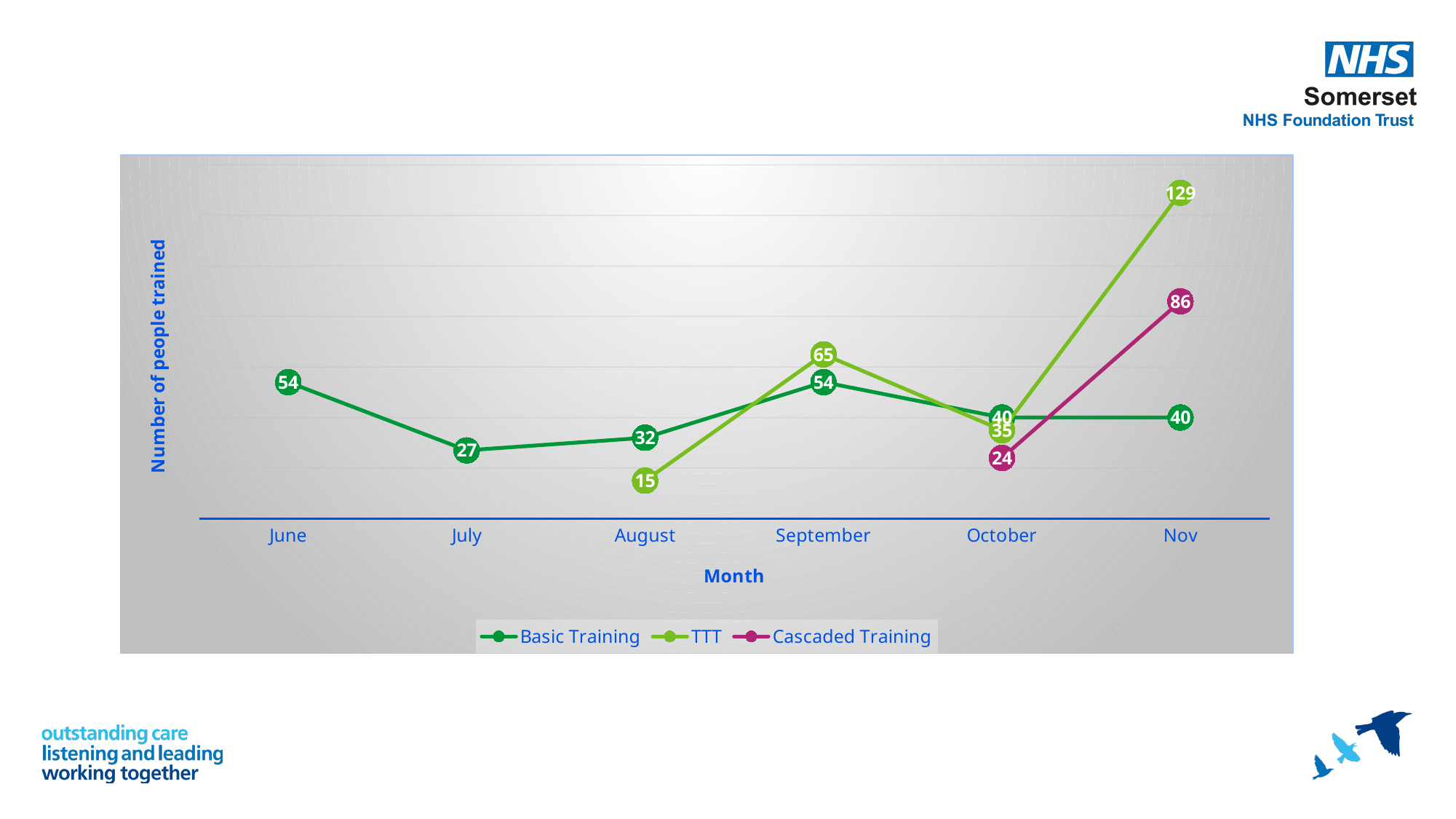
How many series does the legend list? 3 What is the value for Basic Training in June? 54 What is the value for TTT in Nov? 129 What is the difference between TTT and Basic Training in Nov? 89 What is the value for TTT in August? 15 What is the label of the y axis? Number of people trained In which month is Basic Training lowest? July What is the value for Cascaded Training in October? 24 What kind of chart is this? Line chart How many months are shown on the x axis? 6 In which month is TTT highest? Nov Which is larger in September, TTT or Basic Training? TTT